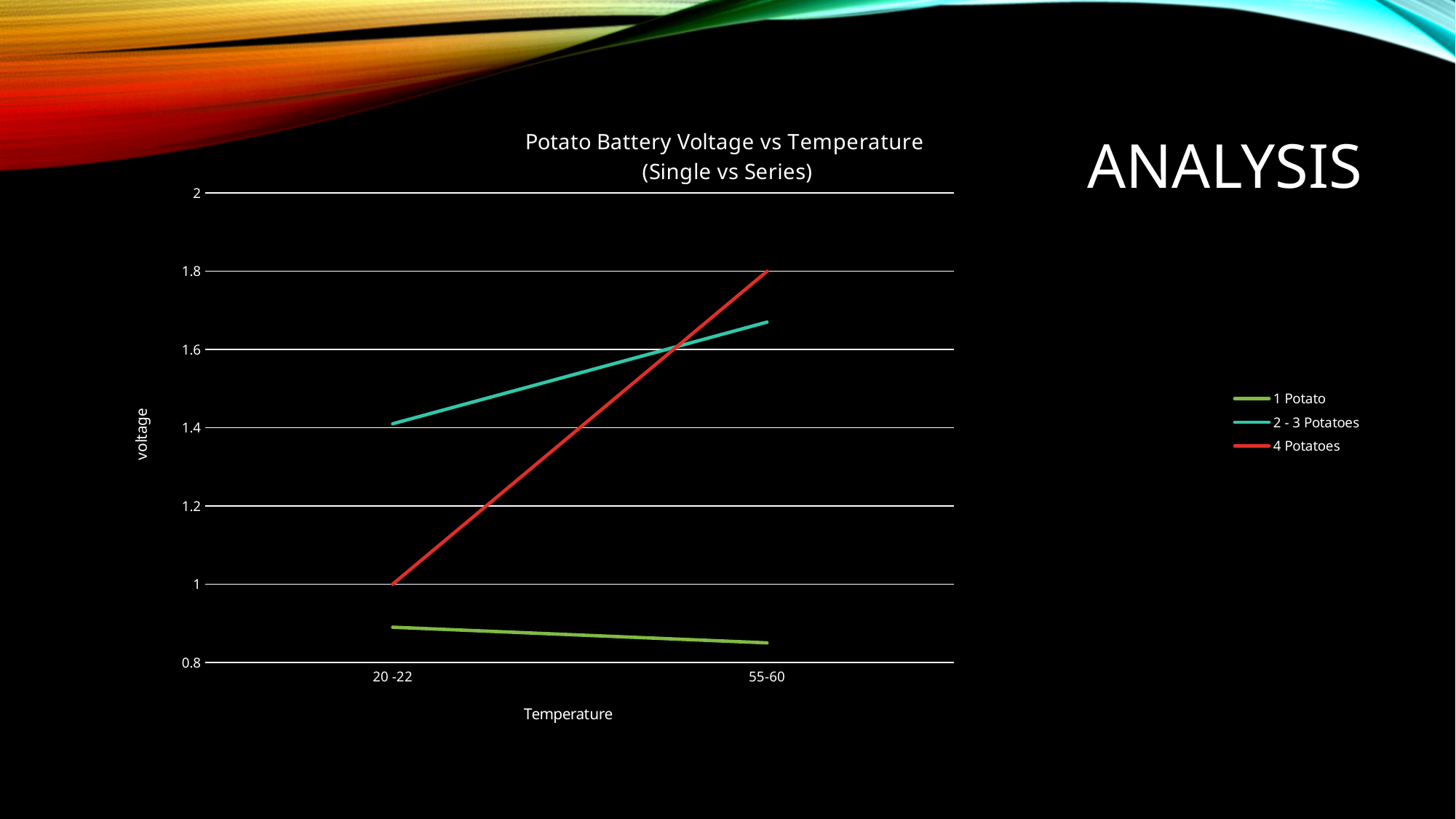
How many temperature categories are shown on the x axis? 2 Is the voltage for 2 - 3 Potatoes at 55-60 greater or less than 1.6? greater Does the voltage for 2 - 3 Potatoes rise or fall from 20 -22 to 55-60? rise How many series does the legend list? 3 By how much does the voltage for 4 Potatoes increase from 20 -22 to 55-60? 0.8 What is the voltage for 4 Potatoes at temperature 20 -22? 1 What kind of chart is shown on the slide? line chart Does the voltage for 1 Potato rise or fall from 20 -22 to 55-60? fall What is the voltage for 4 Potatoes at temperature 55-60? 1.8 At temperature 20 -22, which is higher: 2 - 3 Potatoes or 4 Potatoes? 2 - 3 Potatoes Is the voltage for 1 Potato at 20 -22 greater or less than 1? less Which series has the highest voltage at temperature 55-60? 4 Potatoes